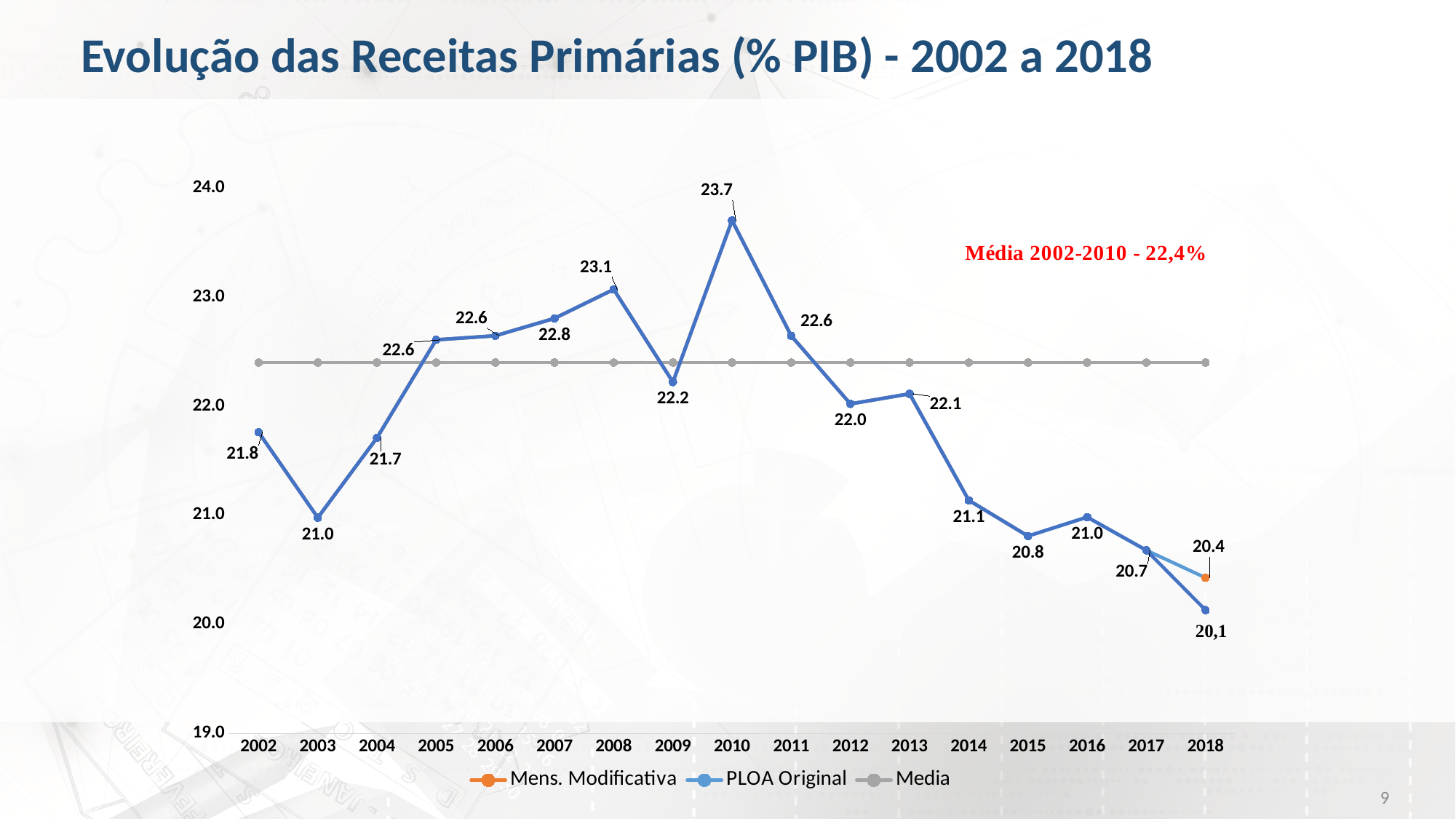
What is the PLOA Original value for 2003? 21.0 What is the PLOA Original value for 2010? 23.7 What is the Mens. Modificativa value for 2018? 20.4 Does the PLOA Original series rise or fall from 2013 to 2015? fall How many years are shown on the x axis? 17 In which year does the PLOA Original series reach its highest value? 2010 What is the difference between the PLOA Original values for 2010 and 2009? 1.5 Which year has the larger PLOA Original value, 2008 or 2011? 2008 Is the value of the Media line greater or less than 22.0? greater What kind of chart is shown on the slide? line chart In which year does the PLOA Original series reach its lowest value? 2018 How many series does the legend list? 3